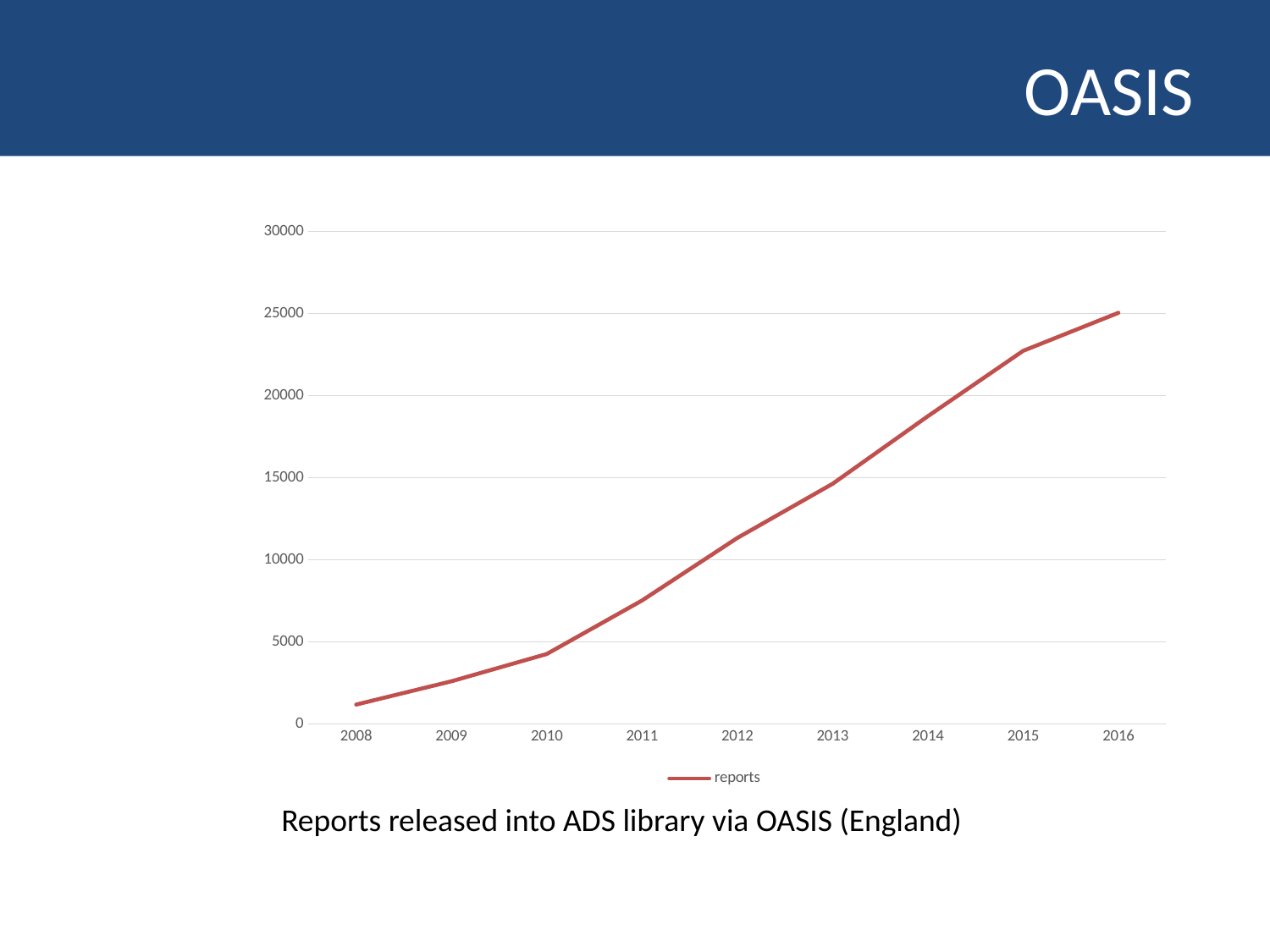
Is the value for 2015 greater or less than 20000? greater Is the value for 2008 greater or less than 5000? less What is the name of the series shown in the legend? reports Which year has more reports, 2010 or 2013? 2013 Which year has the lowest number of reports? 2008 Do the values rise or fall from 2008 to 2016? rise Is the value for 2012 greater or less than 10000? greater Which year has the highest number of reports? 2016 How many series does the legend list? 1 What kind of chart is shown on the slide? line chart How many years are plotted along the x axis? 9